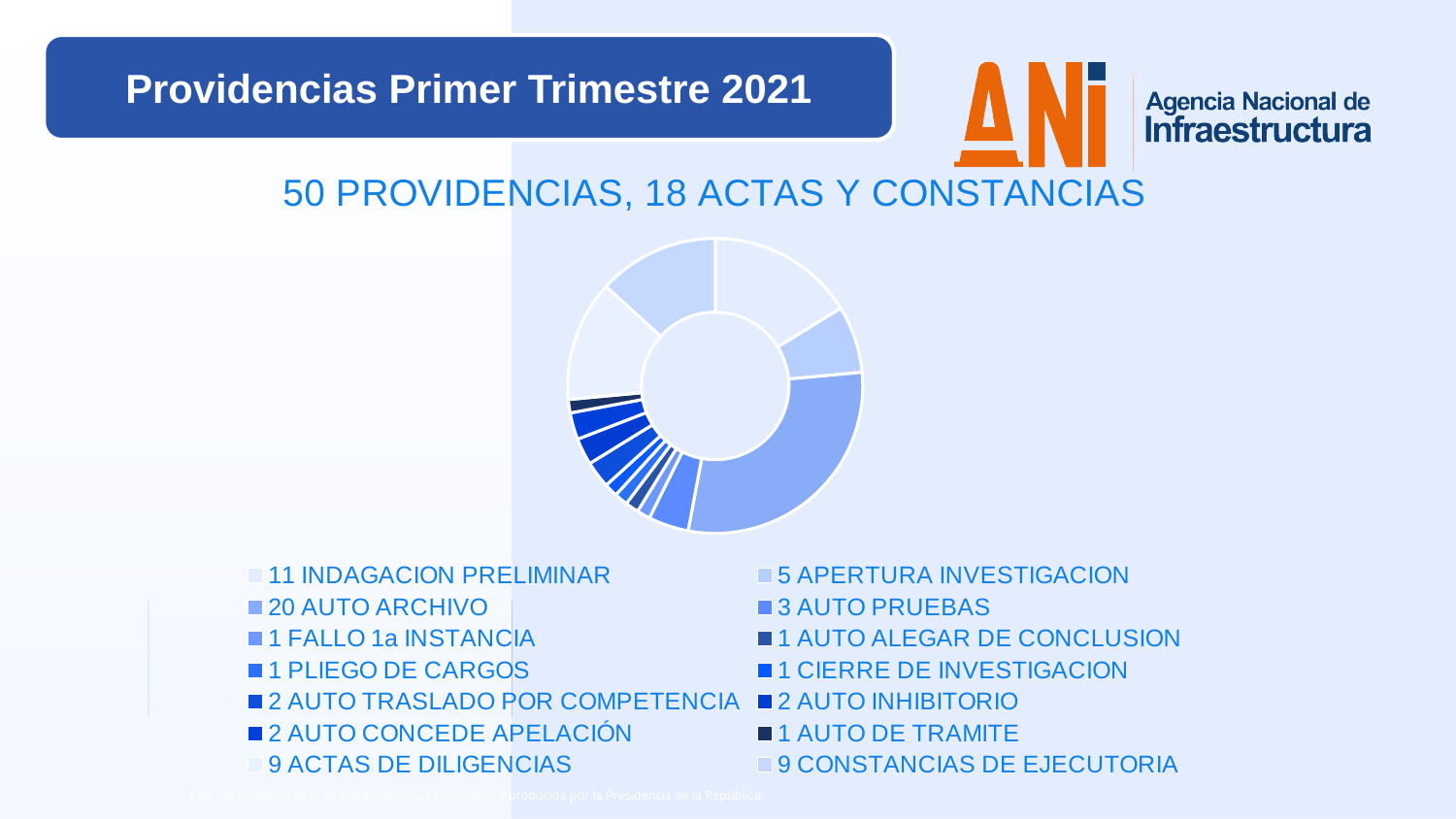
How many categories in the legend have a value of 1? 5 What is the value for AUTO ARCHIVO? 20 Which category has the highest value in the chart? AUTO ARCHIVO What is the value for CONSTANCIAS DE EJECUTORIA? 9 What is the value for AUTO PRUEBAS? 3 What kind of chart is shown on the slide? Doughnut (pie) chart What is the total of all the values listed in the chart's legend? 68 Which is larger, the value for APERTURA INVESTIGACION or the value for AUTO PRUEBAS? APERTURA INVESTIGACION What is the difference between the values for AUTO ARCHIVO and INDAGACION PRELIMINAR? 9 How many categories does the chart's legend list? 14 What is the value for INDAGACION PRELIMINAR? 11 What is the value for APERTURA INVESTIGACION? 5